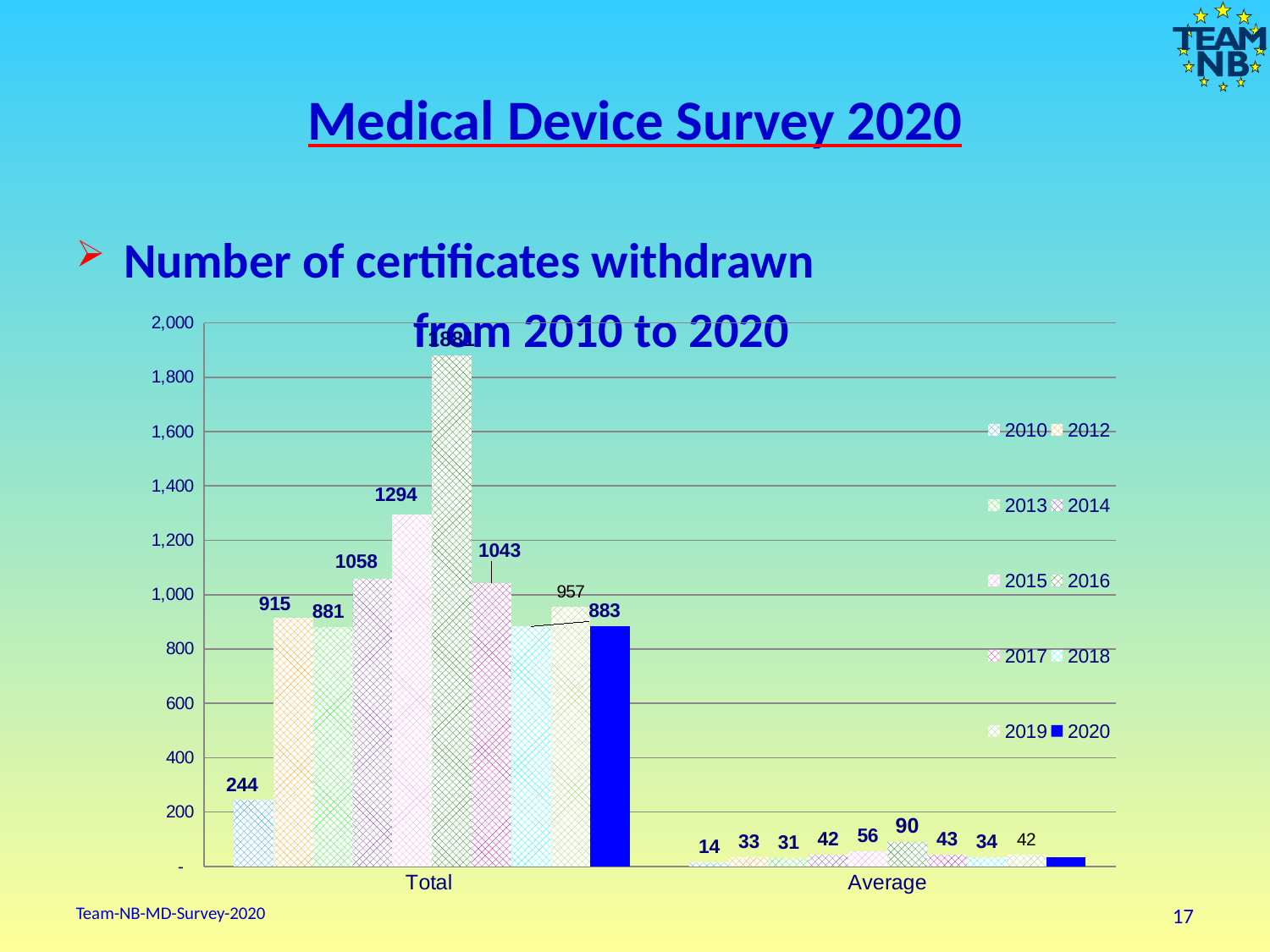
Which year has the highest Total value? 2016 What kind of chart is shown on the slide? bar chart What is the Total value for 2015? 1294 What is the Total value for 2010? 244 How many categories are shown on the x axis? 2 What is the difference between the Total values for 2015 and 2014? 236 How many series does the legend list? 10 What is the Average value for 2016? 90 Is the Total value for 2018 greater or less than 1,000? less Which is larger, the Total value for 2014 or for 2012? 2014 What is the Average value for 2012? 33 Which year has the lowest Average value? 2010